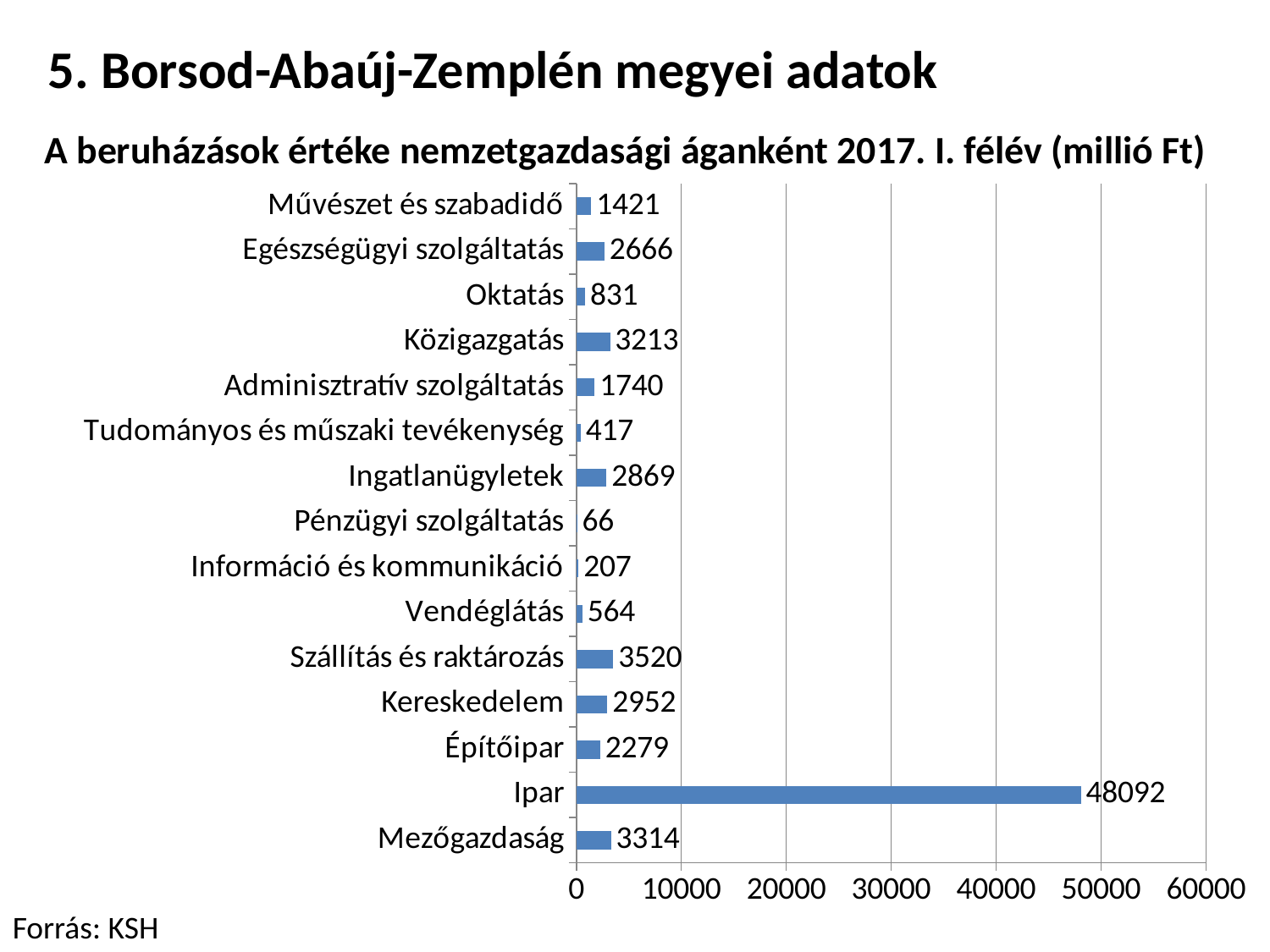
Which is larger, the value for Kereskedelem or the value for Ingatlanügyletek? Kereskedelem How many categories are shown in the chart? 15 What is the value for Ipar? 48092 Which category has the highest value? Ipar Is the value for Ipar greater or less than 40000? greater Which category has the lowest value? Pénzügyi szolgáltatás What kind of chart is shown on the slide? bar chart What is the difference between the values for Szállítás és raktározás and Közigazgatás? 307 What is the difference between the values for Ipar and Mezőgazdaság? 44778 What is the value for Szállítás és raktározás? 3520 What is the value for Mezőgazdaság? 3314 What is the value for Pénzügyi szolgáltatás? 66